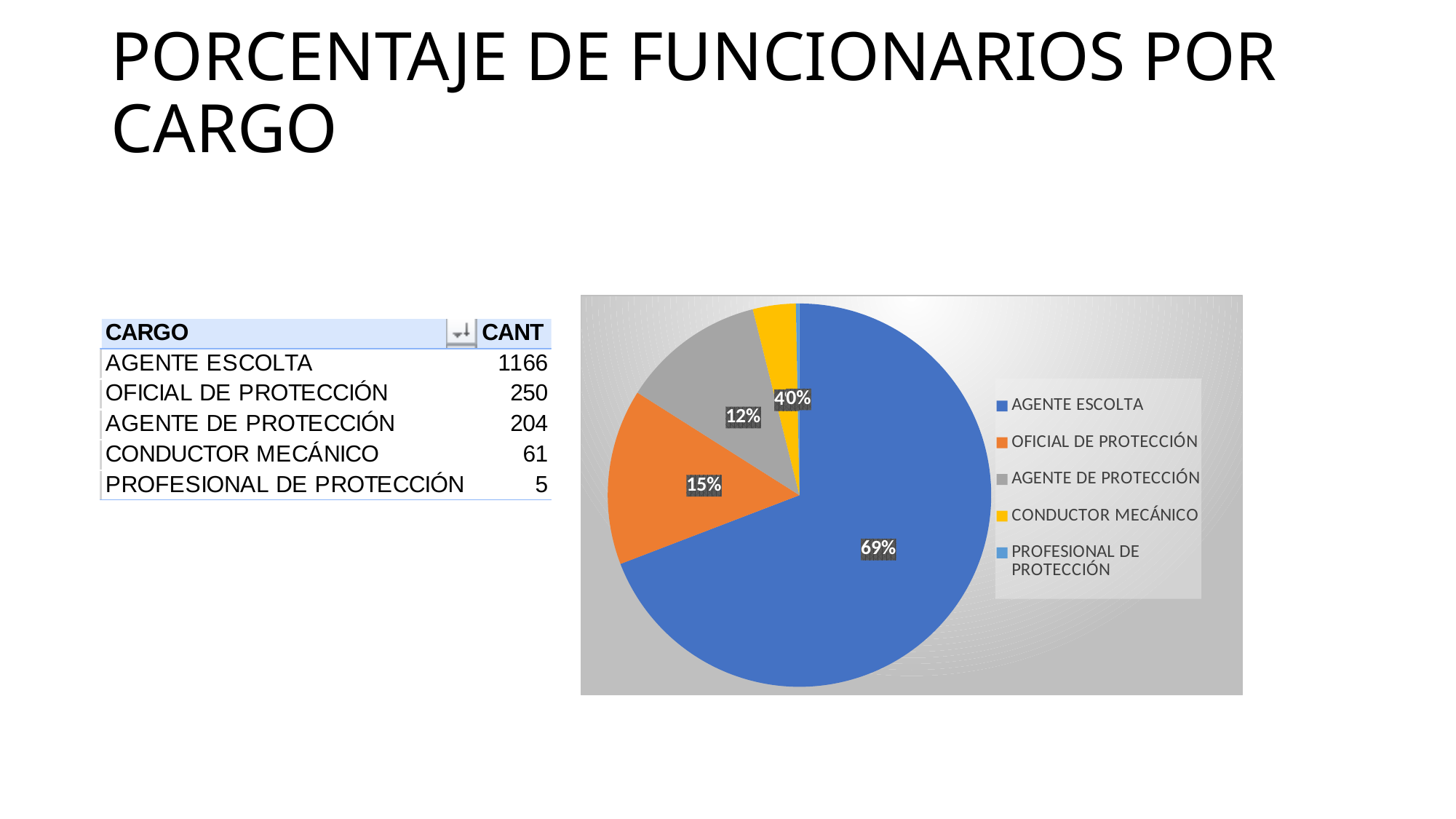
Which category has the smallest slice of the pie? PROFESIONAL DE PROTECCIÓN What kind of chart is shown on the slide? Pie chart What colour is the AGENTE ESCOLTA slice in the pie chart? Blue What colour is the CONDUCTOR MECÁNICO slice in the pie chart? Yellow What is the difference in percentage points between the AGENTE ESCOLTA slice and the OFICIAL DE PROTECCIÓN slice? 54 What share of the pie does AGENTE ESCOLTA represent? 69% What share of the pie does AGENTE DE PROTECCIÓN represent? 12% How many categories does the legend of the pie chart list? 5 Which slice is larger, AGENTE DE PROTECCIÓN or CONDUCTOR MECÁNICO? AGENTE DE PROTECCIÓN Which slice is larger, OFICIAL DE PROTECCIÓN or AGENTE DE PROTECCIÓN? OFICIAL DE PROTECCIÓN What share of the pie does OFICIAL DE PROTECCIÓN represent? 15% Which category has the largest slice of the pie? AGENTE ESCOLTA